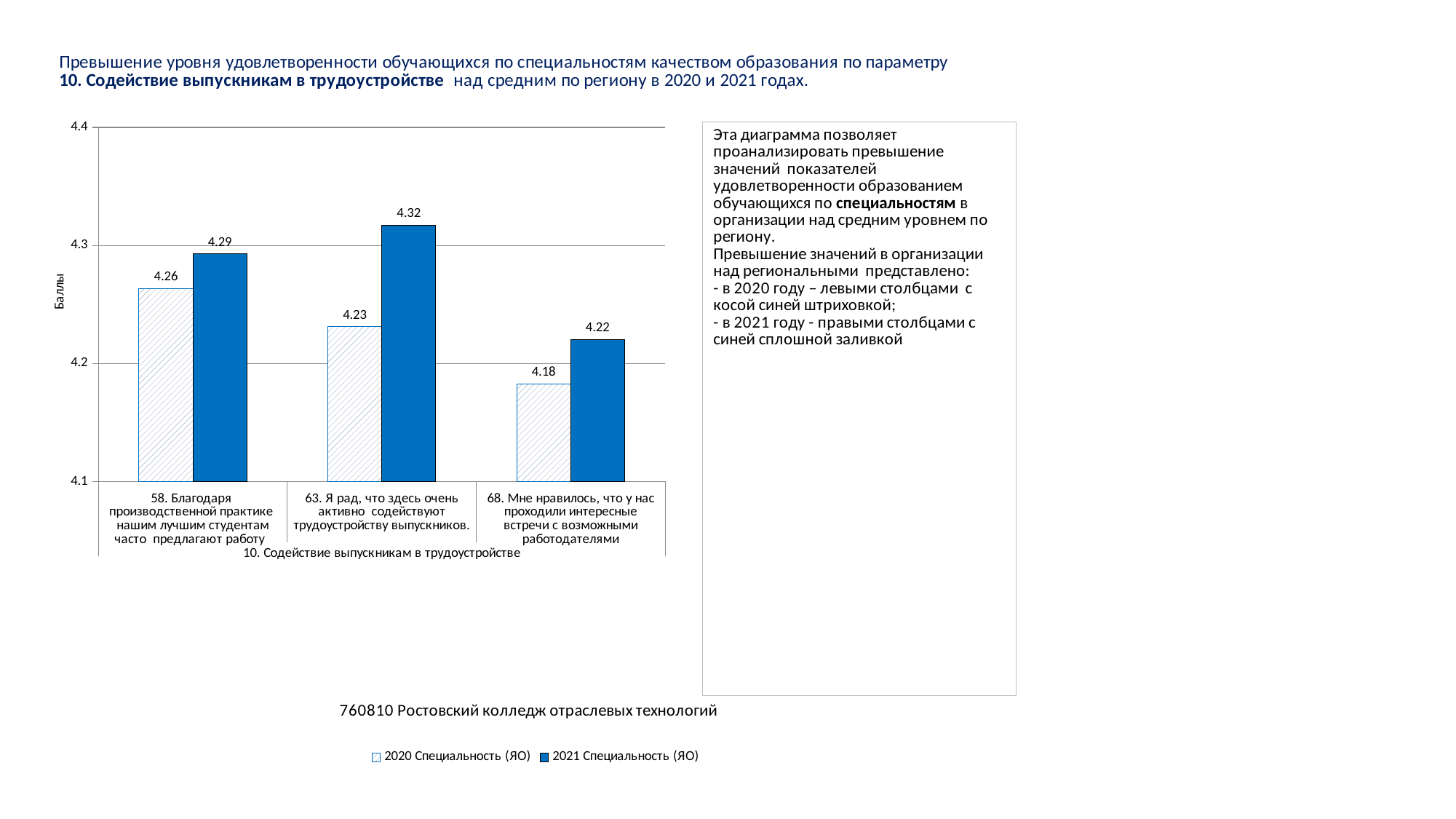
Is the 2021 Специальность (ЯО) value for category 68 greater or less than 4.3? less What is the value for 2020 Специальность (ЯО) for category 68 (Мне нравилось, что у нас проходили интересные встречи с возможными работодателями)? 4.18 What is the value for 2021 Специальность (ЯО) for category 63 (Я рад, что здесь очень активно содействуют трудоустройству выпускников)? 4.32 Which category has the highest value for 2021 Специальность (ЯО)? 63. Я рад, что здесь очень активно содействуют трудоустройству выпускников. Which category has the lowest value for 2020 Специальность (ЯО)? 68. Мне нравилось, что у нас проходили интересные встречи с возможными работодателями For category 58, which series has the larger value: 2020 Специальность (ЯО) or 2021 Специальность (ЯО)? 2021 Специальность (ЯО) What is the difference between the 2021 and 2020 values for category 68? 0.04 What is the difference between the 2021 and 2020 values for category 63? 0.09 How many categories are shown on the x axis of the chart? 3 How many series does the chart legend list? 2 What kind of chart is shown on the slide? bar chart What is the value for 2020 Специальность (ЯО) for category 58 (Благодаря производственной практике нашим лучшим студентам часто предлагают работу)? 4.26